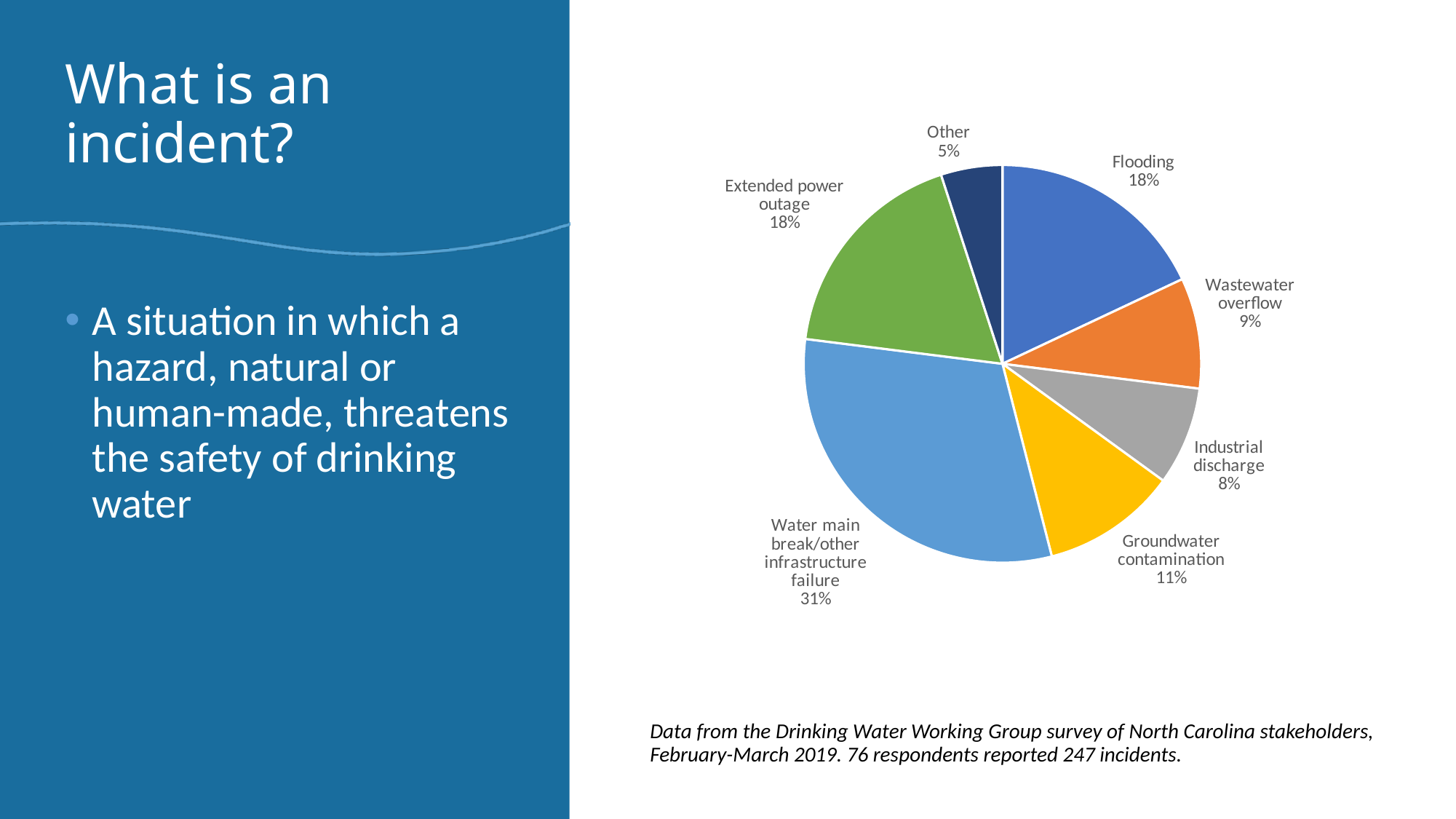
What percentage of the pie is Flooding? 18% What percentage is shown for Wastewater overflow? 9% What colour is the Extended power outage slice? green What kind of chart is shown on the slide? pie chart How many slices does the pie chart have? 7 What percentage is shown for Groundwater contamination? 11% Which category has the smallest slice of the pie? Other Which is larger, Industrial discharge or Groundwater contamination? Groundwater contamination What is the combined percentage of Flooding and Extended power outage? 36% What share of incidents is Water main break/other infrastructure failure? 31% What is the difference in percentage points between Water main break/other infrastructure failure and Extended power outage? 13 Which category has the largest slice of the pie? Water main break/other infrastructure failure